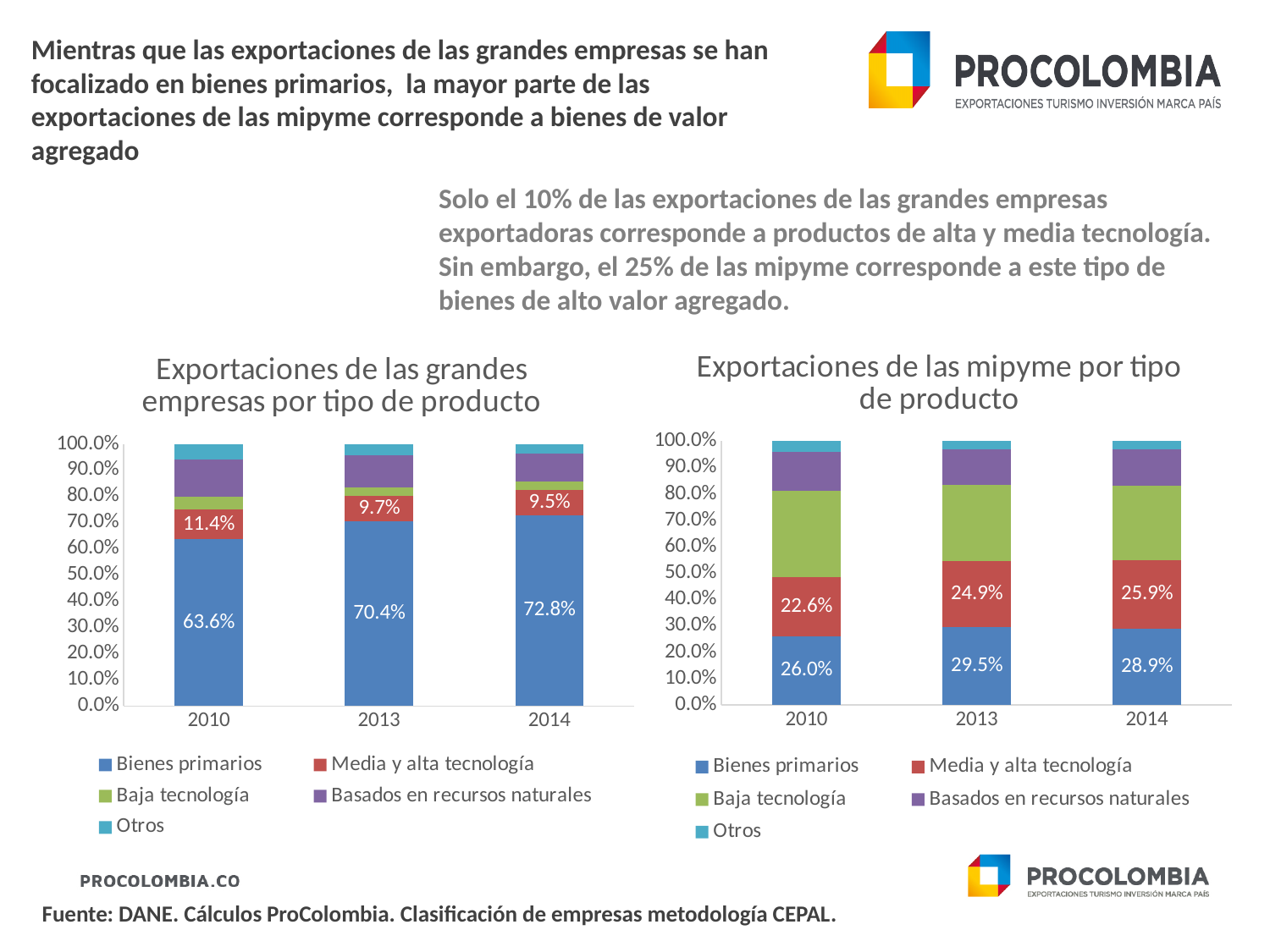
In the chart 'Exportaciones de las grandes empresas por tipo de producto', which year has the highest value for Bienes primarios? 2014 In the chart 'Exportaciones de las mipyme por tipo de producto', which year has the lowest value for Bienes primarios? 2010 In the chart 'Exportaciones de las grandes empresas por tipo de producto', what is the difference between the Bienes primarios values for 2014 and 2010? 9.2% In the chart 'Exportaciones de las mipyme por tipo de producto', which series is shown in green? Baja tecnología In the chart 'Exportaciones de las grandes empresas por tipo de producto', what is the value for Bienes primarios in 2014? 72.8% In the chart 'Exportaciones de las grandes empresas por tipo de producto', does the Media y alta tecnología value rise or fall from 2010 to 2014? Fall In the chart 'Exportaciones de las mipyme por tipo de producto', is the Media y alta tecnología value larger in 2014 or in 2010? 2014 How many series does the legend of the chart 'Exportaciones de las grandes empresas por tipo de producto' list? 5 In the chart 'Exportaciones de las mipyme por tipo de producto', what is the value for Media y alta tecnología in 2013? 24.9% In the chart 'Exportaciones de las grandes empresas por tipo de producto', is the value for Media y alta tecnología in 2010 greater or less than 10.0%? greater What kind of chart is 'Exportaciones de las mipyme por tipo de producto'? Stacked bar chart How many years are shown on the x axis of the chart 'Exportaciones de las mipyme por tipo de producto'? 3